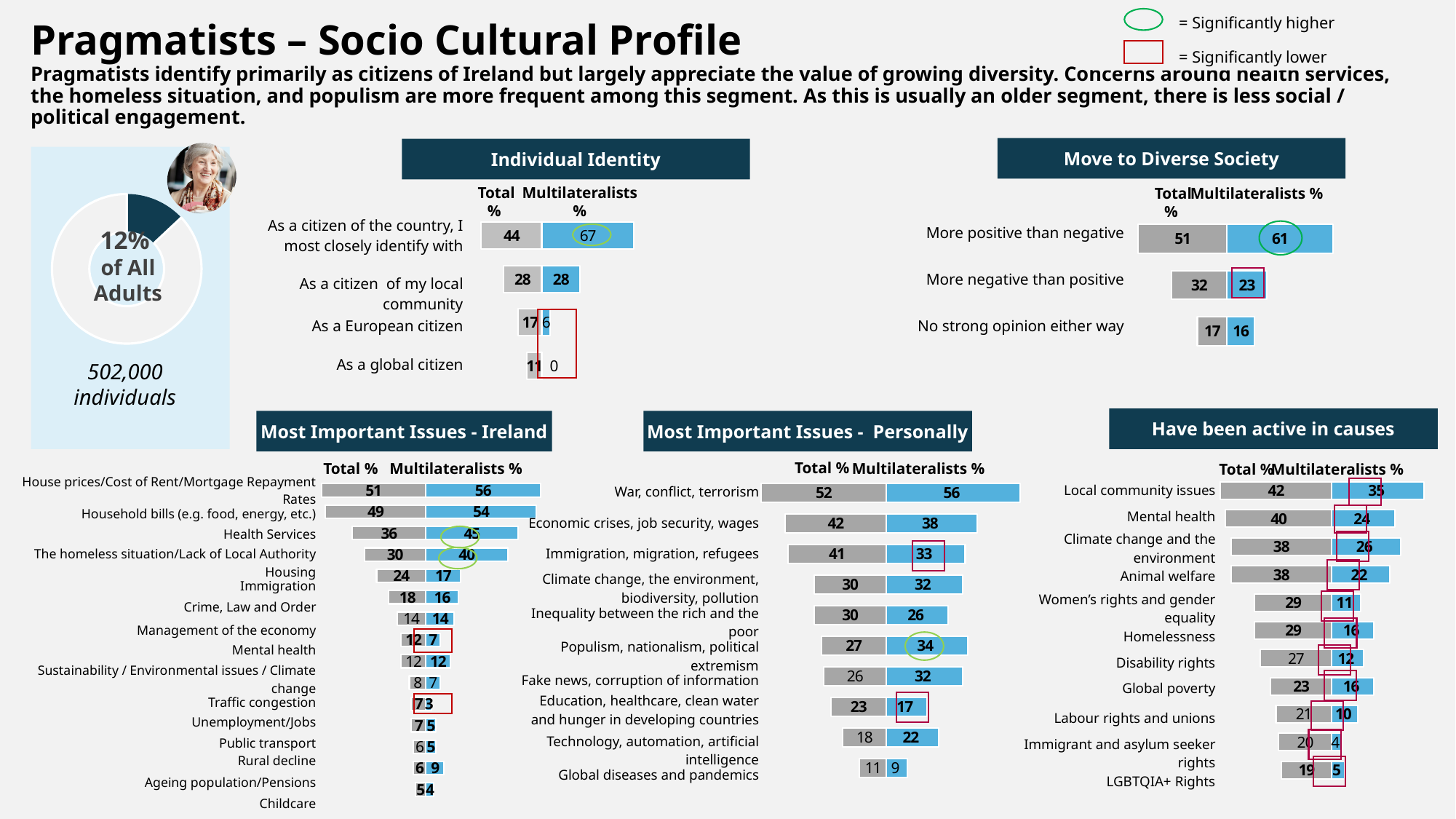
How many causes are listed in the Have been active in causes chart? 11 In the Most Important Issues - Ireland chart, which issue has the highest Total %? House prices/Cost of Rent/Mortgage Repayment Rates What percentage of all adults does the donut chart on the left show for Pragmatists? 12% In the Most Important Issues - Personally chart, what is the Total % for 'Populism, nationalism, political extremism'? 27 In the Most Important Issues - Ireland chart, what is the Multilateralists % for Health Services? 45 In the Most Important Issues - Personally chart, which is larger for 'Economic crises, job security, wages': Total % or Multilateralists %? Total % In the Have been active in causes chart, what is the difference between the Total % and Multilateralists % for Mental health? 16 In the Have been active in causes chart, what is the Multilateralists % for 'Immigrant and asylum seeker rights'? 4 In the Individual Identity chart, what is the Total % for 'As a European citizen'? 17 In the Move to Diverse Society chart, which response has the lowest Total %? No strong opinion either way In the Move to Diverse Society chart, what is the difference between the Total % and Multilateralists % for 'More positive than negative'? 10 In the Individual Identity chart, what is the Multilateralists % for 'As a citizen of the country, I most closely identify with'? 67